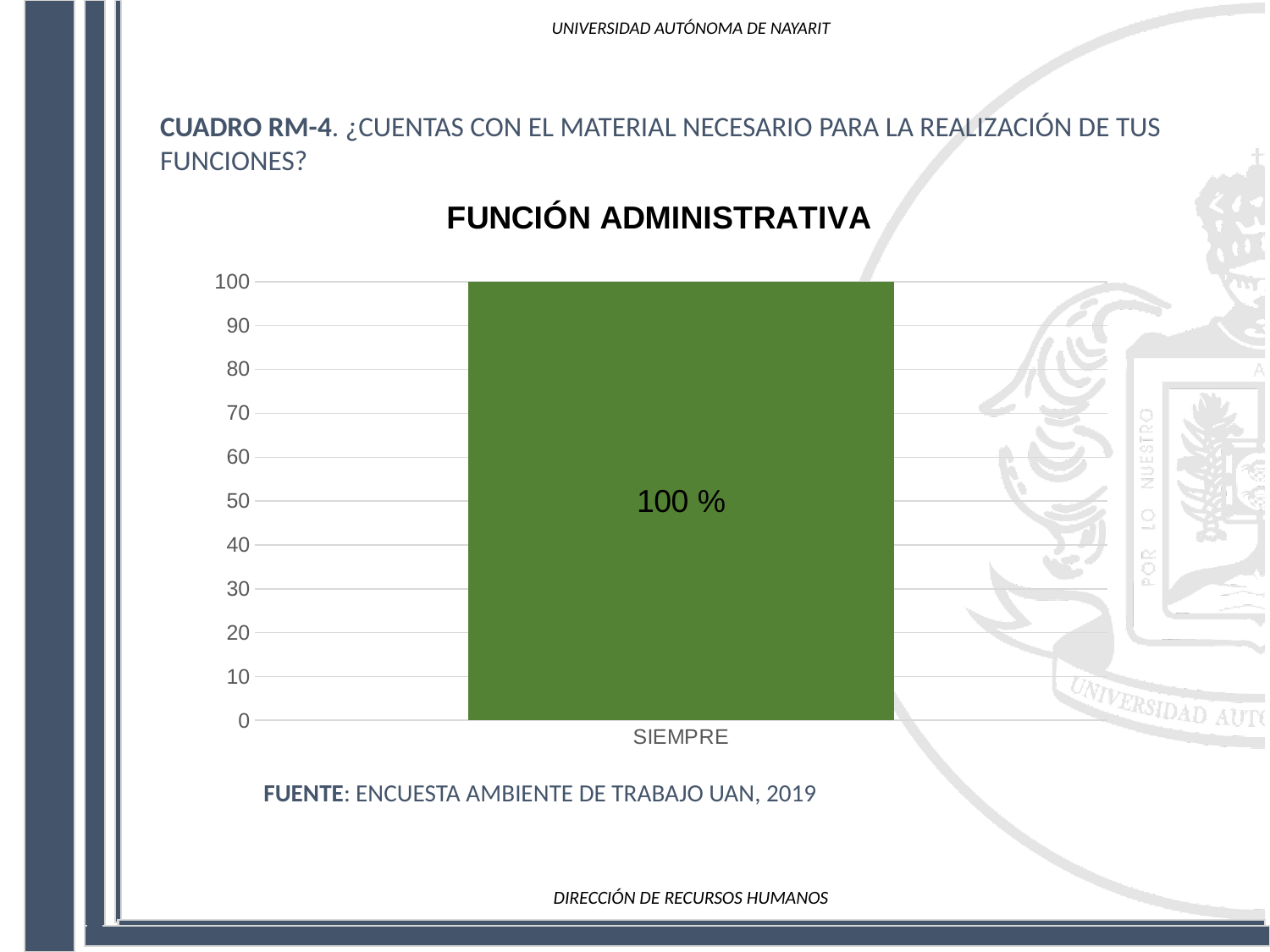
What is the value for SIEMPRE? 100 % How many categories are shown on the x axis? 1 Is the value for SIEMPRE greater or less than 50? greater What is the label of the only category on the x axis? SIEMPRE What is the highest value shown on the y axis? 100 What kind of chart is shown on the slide? bar chart What is the title of the chart? FUNCIÓN ADMINISTRATIVA